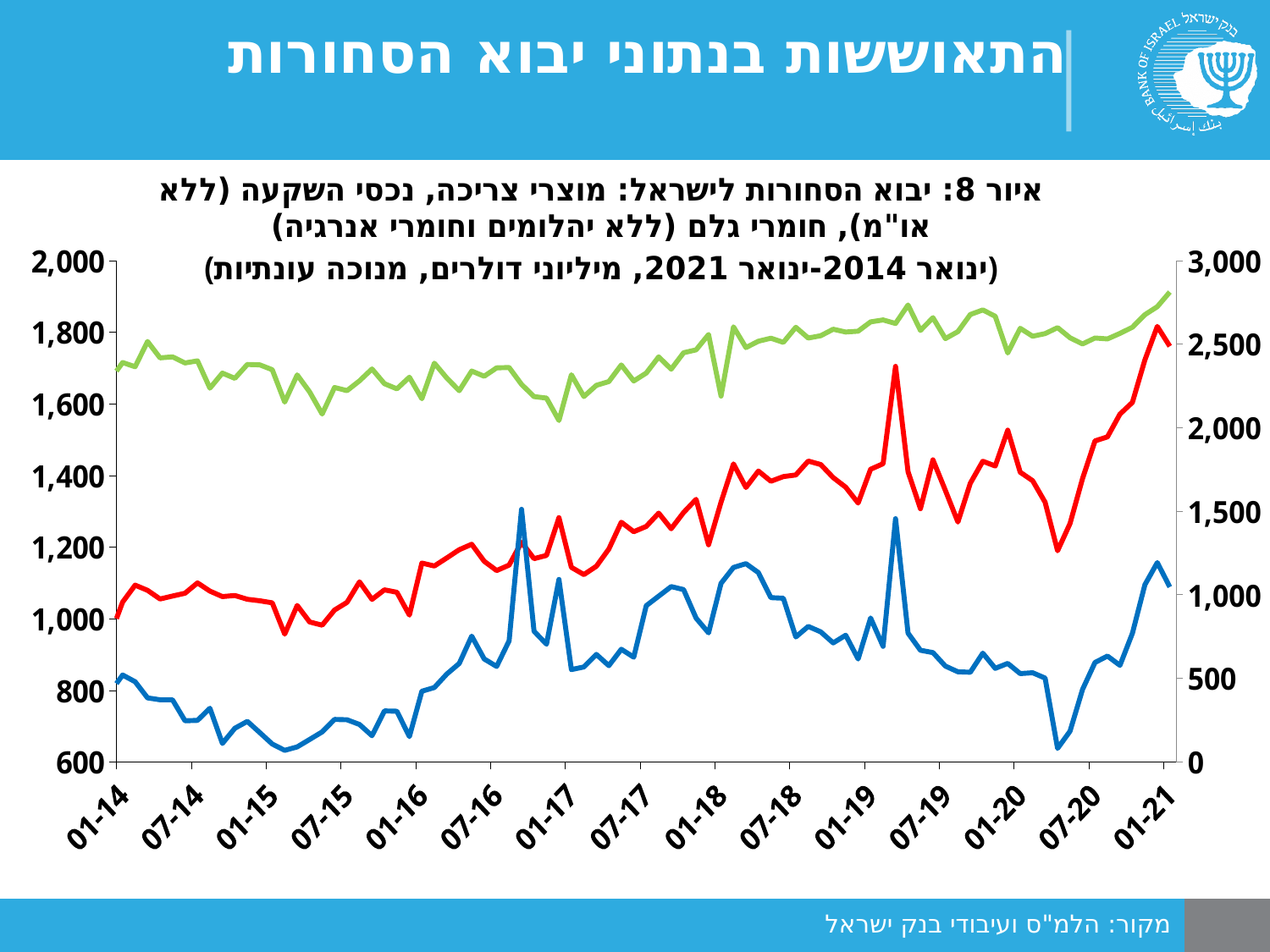
Reading against the right axis, is the green line at 01-21 greater or less than 2,500? greater Does the blue line rise or fall between 01-14 and 01-15? fall What is the highest value shown on the left y axis of the chart? 2,000 Reading against the left axis, is the red line at 01-21 greater or less than 1,600? greater Does the red line rise or fall between 07-20 and 01-21? rise Does the blue line rise or fall between 07-20 and 01-21? rise At 01-21, which line is plotted highest on the chart: green, red or blue? green At 01-21, which line is plotted lowest on the chart: green, red or blue? blue How many tick labels are shown on the x axis of the chart? 15 What kind of chart is shown on the slide? line chart How many lines are plotted on the chart? 3 Reading against the left axis, is the blue line at 01-14 greater or less than 1,000? less